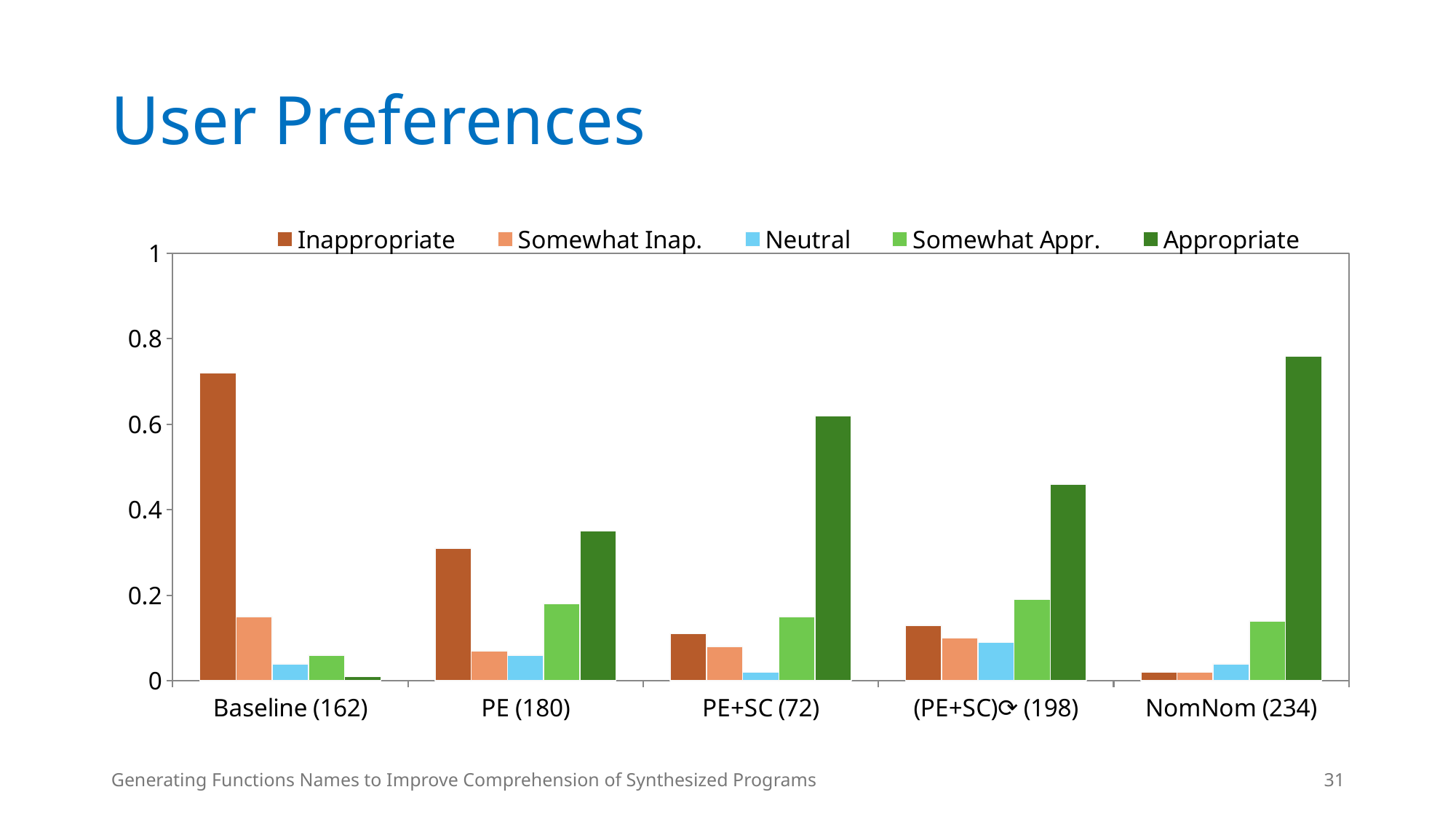
Is the Appropriate value for (PE+SC)⟳ (198) greater or less than 0.4? greater How many categories are shown along the x axis? 5 Is the Appropriate value for PE (180) greater or less than 0.4? less Is the Appropriate value for NomNom (234) greater or less than 0.6? greater How many series does the legend list? 5 Which category has the highest Appropriate value? NomNom (234) Which has the larger Appropriate value, PE+SC (72) or (PE+SC)⟳ (198)? PE+SC (72) Which category has the highest Inappropriate value? Baseline (162) What is the title of the slide? User Preferences What kind of chart is shown on the slide? bar chart Which category has the lowest Appropriate value? Baseline (162)